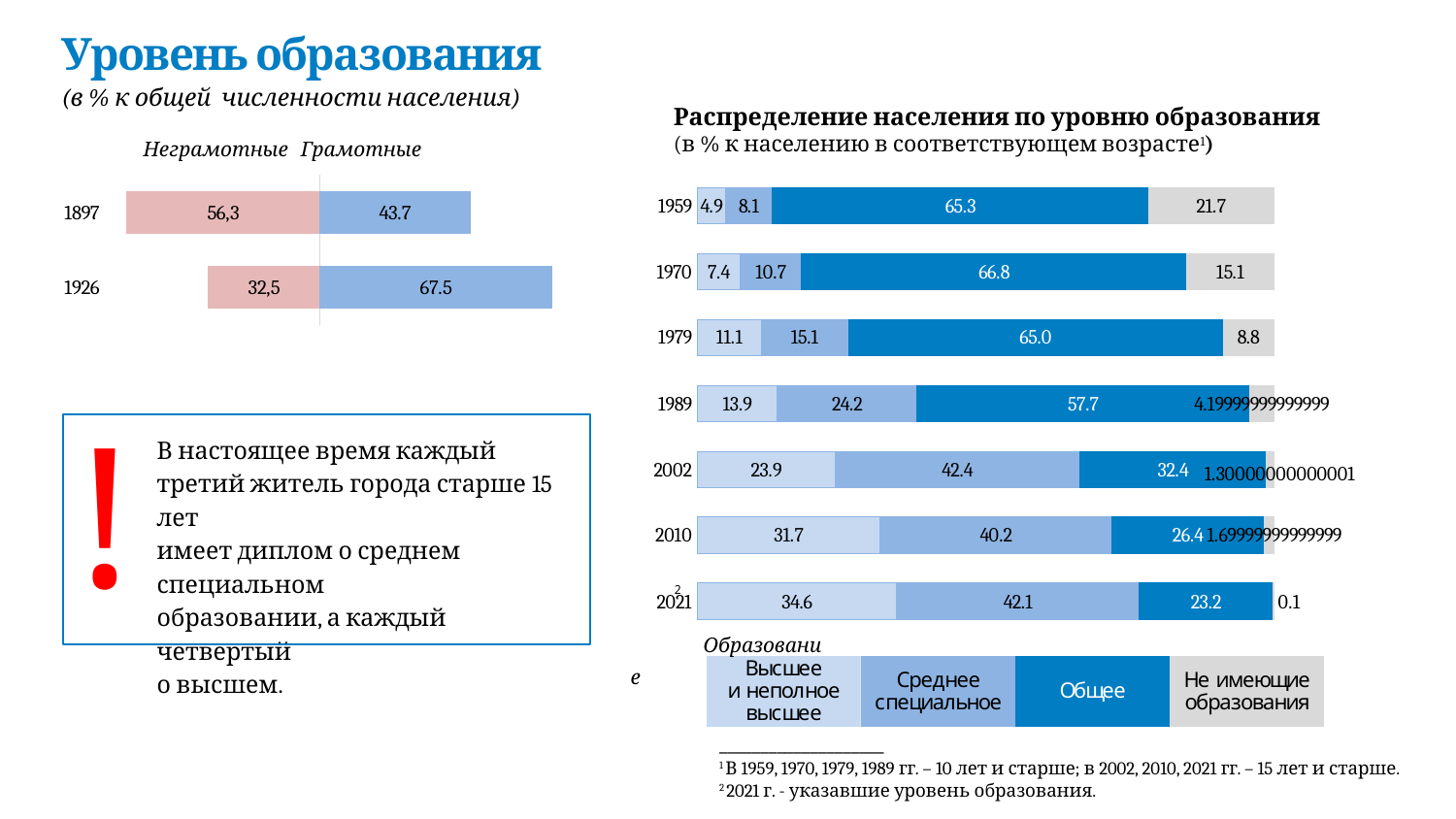
In the right chart (Распределение населения по уровню образования), which year has the highest value for Высшее и неполное высшее? 2021 In the right chart (Распределение населения по уровню образования), how many years are shown? 7 In the left chart (Уровень образования), what is the value for Грамотные in 1926? 67.5 In the left chart (Уровень образования), what kind of chart is shown? bar chart In the left chart (Уровень образования), by how much does the Грамотные value exceed the Неграмотные value in 1926? 35 In the left chart (Уровень образования), how many series are shown? 2 In the right chart (Распределение населения по уровню образования), which year has the highest value for Не имеющие образования? 1959 In the right chart (Распределение населения по уровню образования), what is the value for Общее in 1970? 66.8 In the right chart (Распределение населения по уровню образования), how many categories does the legend list? 4 In the left chart (Уровень образования), what is the value for Неграмотные in 1897? 56,3 In the right chart (Распределение населения по уровню образования), what is the value for Высшее и неполное высшее in 2021? 34.6 In the right chart (Распределение населения по уровню образования), is the value for Общее larger in 1979 or in 2002? 1979